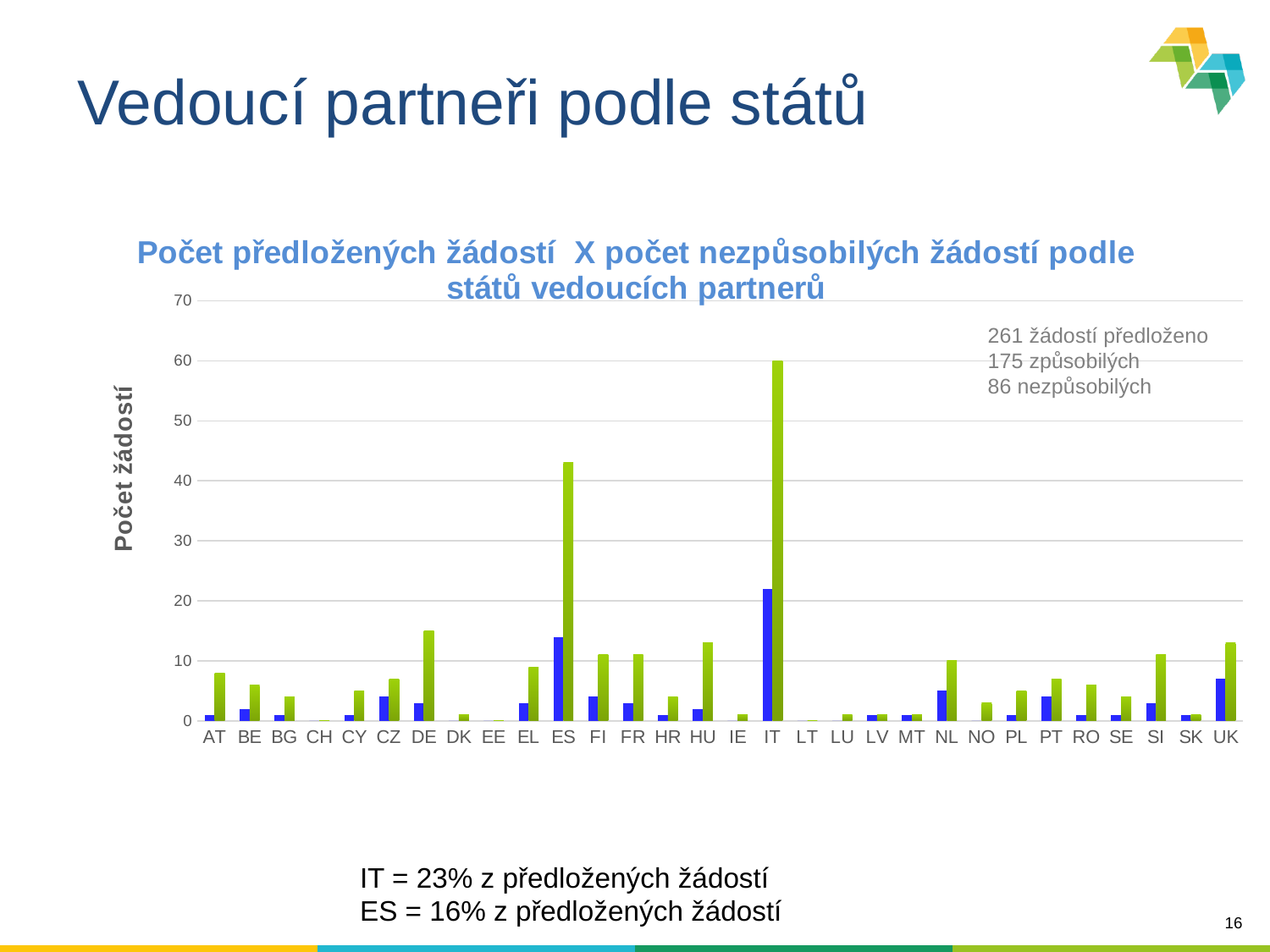
Is the green bar for DE greater or less than 20? less Which has the taller blue bar, ES or IT? IT Is the blue bar for IT greater or less than 20? greater Is the green bar for NL greater or less than 20? less What kind of chart is shown on the slide? bar chart How many countries are shown on the x axis of the chart? 30 What is the label of the y axis of the chart? Počet žádostí Which has the taller green bar, ES or IT? IT Which country has the tallest green bar in the chart? IT